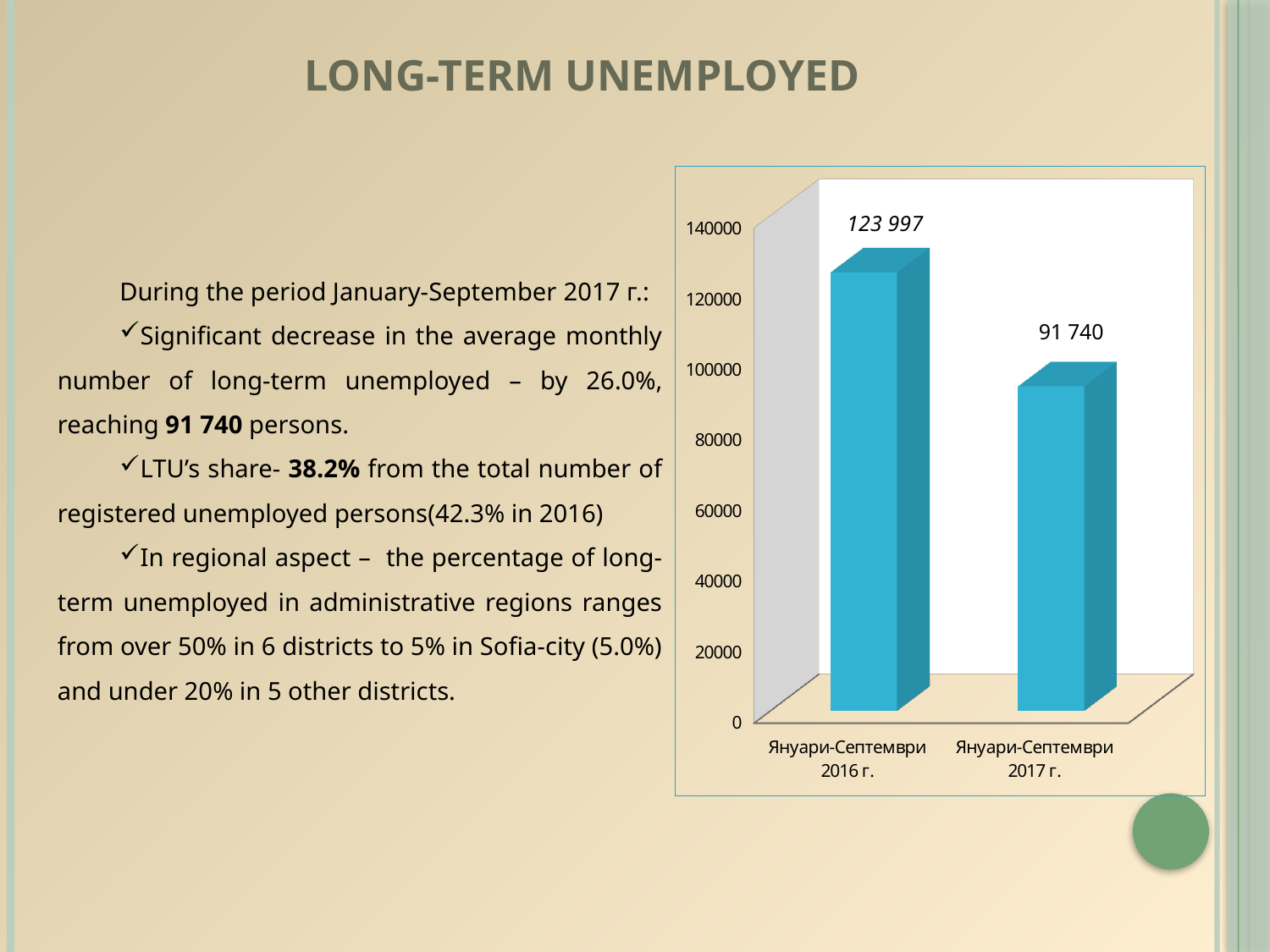
Which is larger, the value for Януари-Септември 2016 г. or for Януари-Септември 2017 г.? Януари-Септември 2016 г. What is the highest value shown on the vertical axis of the chart? 140000 Do the values rise or fall from Януари-Септември 2016 г. to Януари-Септември 2017 г.? fall Which category has the lowest value? Януари-Септември 2017 г. Is the value for Януари-Септември 2016 г. greater or less than 120000? greater Which category has the highest value? Януари-Септември 2016 г. What is the difference between the values for Януари-Септември 2016 г. and Януари-Септември 2017 г.? 32 257 What is the value for Януари-Септември 2017 г.? 91 740 What is the value for Януари-Септември 2016 г.? 123 997 What kind of chart is shown on the slide? bar chart Is the value for Януари-Септември 2017 г. greater or less than 100000? less How many categories are shown on the chart? 2